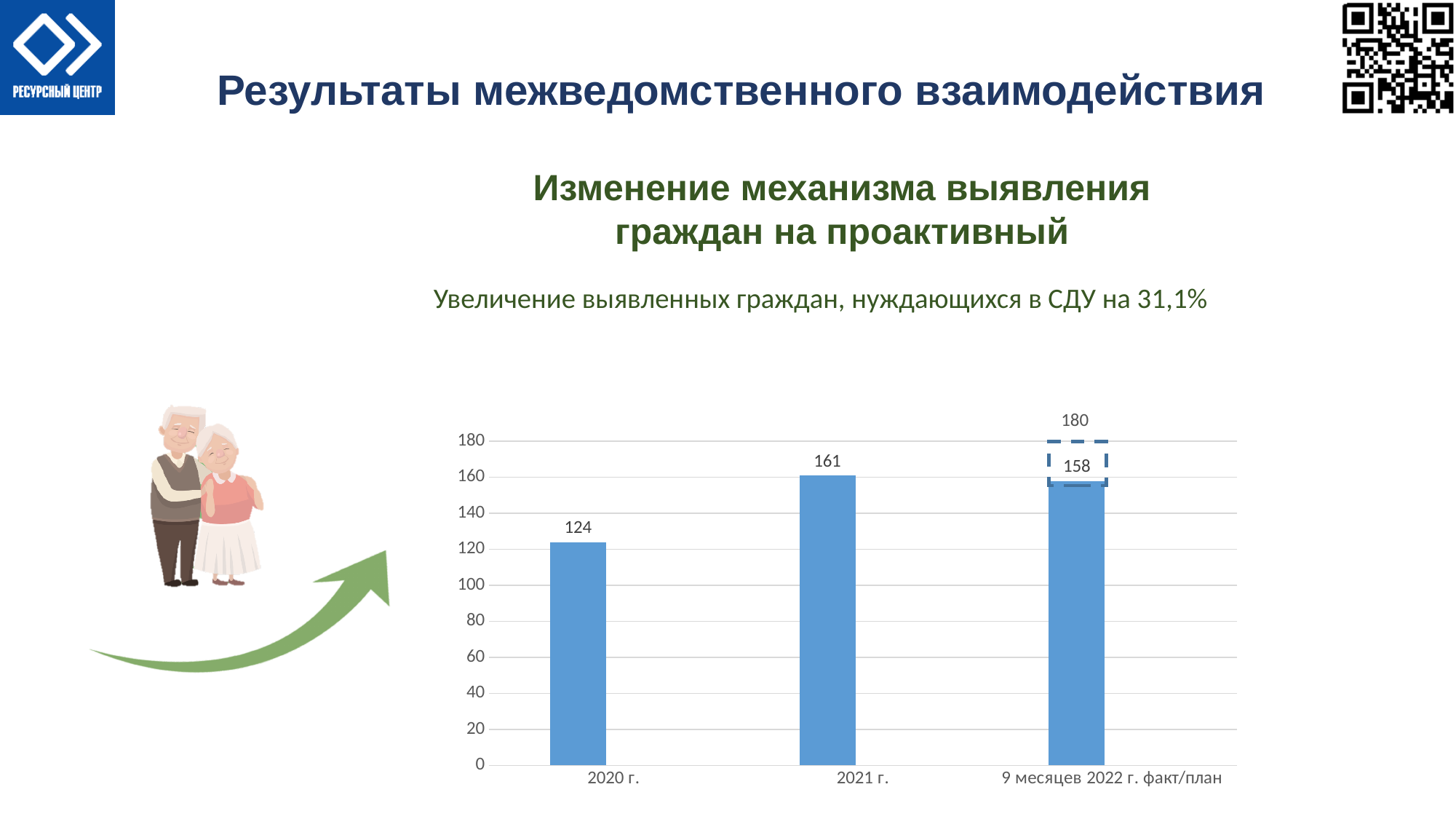
What kind of chart is shown on the slide? bar chart What is the planned (план) value shown above the dashed outline for 9 месяцев 2022 г.? 180 Which category has the lowest bar? 2020 г. Which category has the highest solid bar? 2021 г. What is the value for 2021 г.? 161 What is the actual (факт) value shown for 9 месяцев 2022 г.? 158 Which is larger, the value for 2021 г. or the actual value for 9 месяцев 2022 г.? 2021 г. What is the value for 2020 г.? 124 How many categories are shown on the x axis? 3 What is the difference between the values for 2021 г. and 2020 г.? 37 What percentage increase in identified citizens needing СДУ is stated in the text above the chart? 31,1% What is the difference between the plan value (180) and the actual value (158) for 9 месяцев 2022 г.? 22